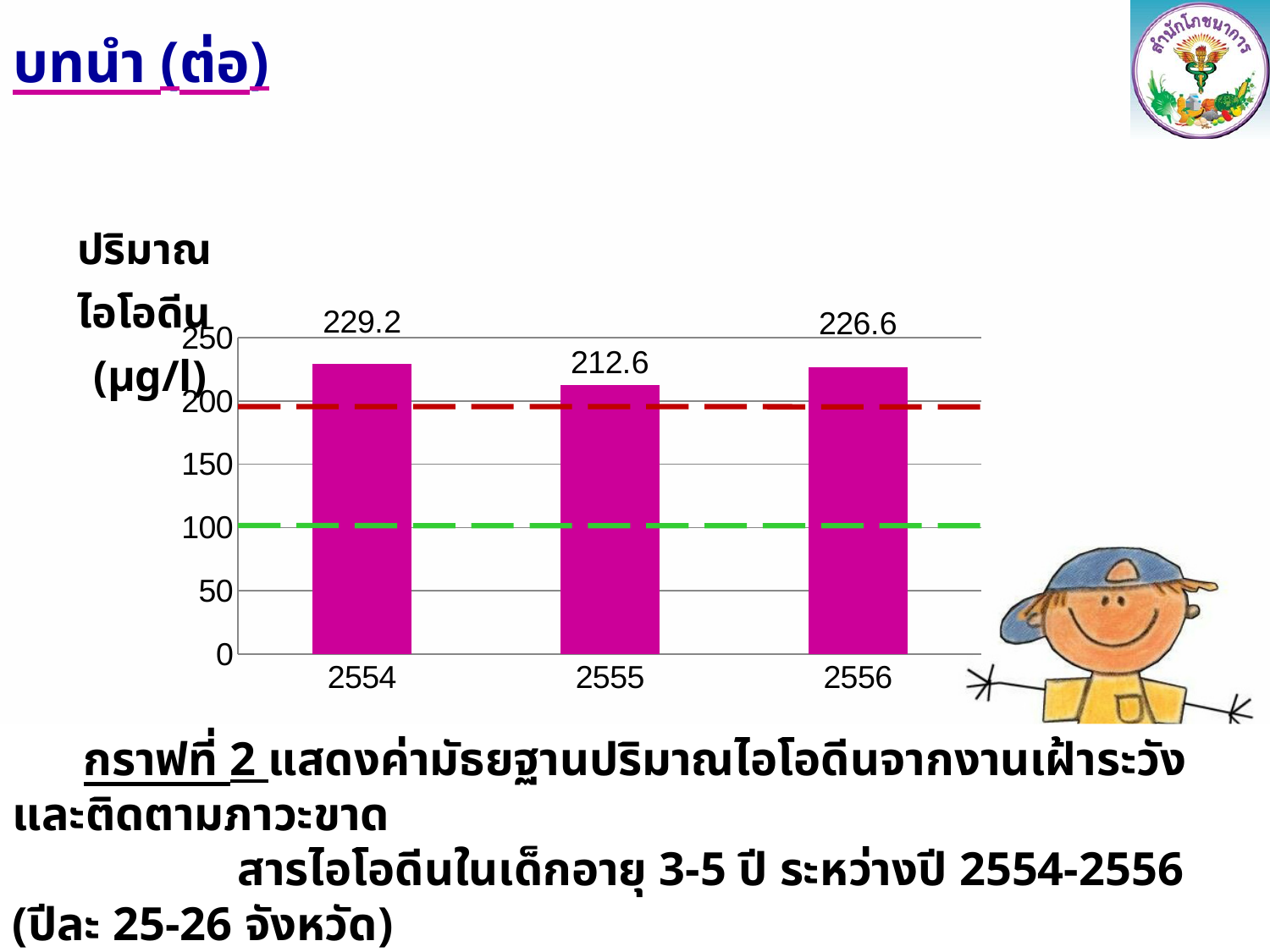
What is the value for 2555? 212.6 Which year has the highest value? 2554 Is the value for 2555 greater or less than 200? greater What is the value for 2554? 229.2 What is the difference between the values for 2554 and 2555? 16.6 How many years are shown on the x axis? 3 What is the difference between the values for 2556 and 2555? 14 What unit is given in the y-axis label? µg/l Which year has the lowest value? 2555 What kind of chart is shown on the slide? bar chart Which is larger, the value for 2554 or the value for 2556? 2554 What is the value for 2556? 226.6